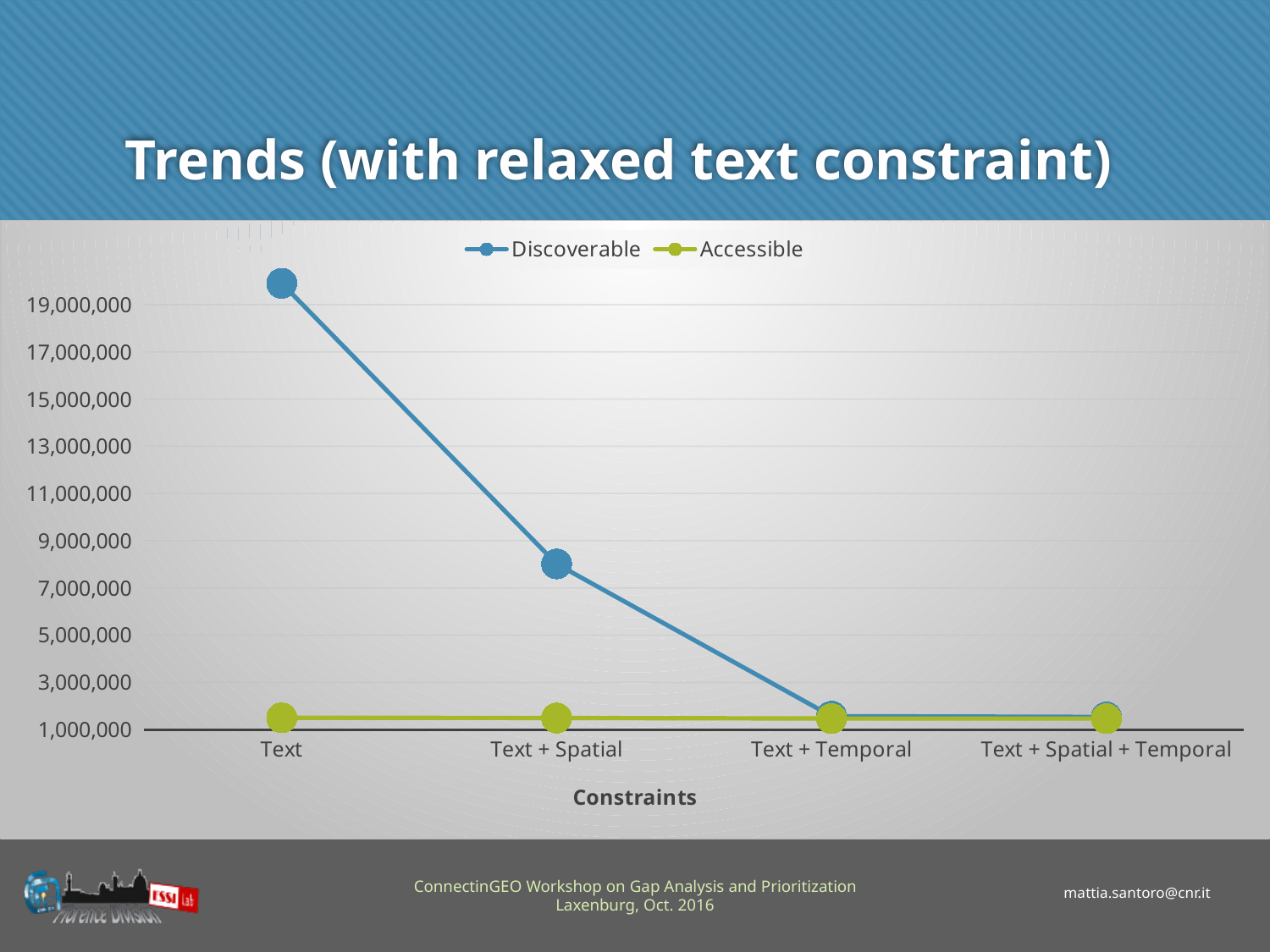
Is the Discoverable value for Text + Spatial greater or less than 7,000,000? greater Which category has the highest Discoverable value? Text Is the Discoverable value for Text greater or less than 19,000,000? greater How many categories are shown on the x axis? 4 Is the Accessible value for Text greater or less than 3,000,000? less Which is larger for Text + Spatial, the Discoverable value or the Accessible value? Discoverable What is the title of the slide? Trends (with relaxed text constraint) Does the Discoverable series rise or fall from Text to Text + Temporal? fall What kind of chart is shown on the slide? line chart What is the label of the x axis? Constraints How many series does the legend list? 2